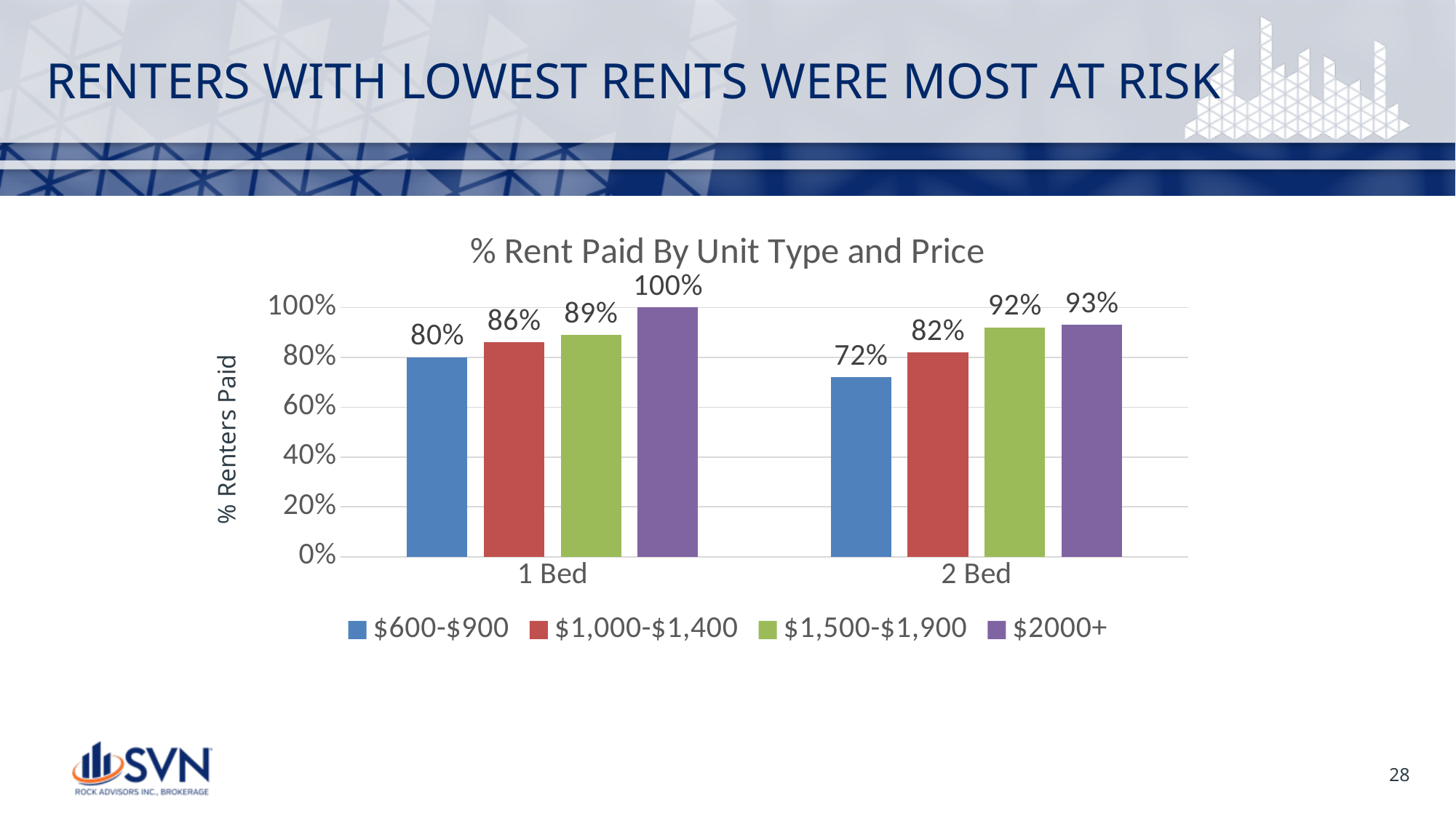
What is the value for $600-$900 in the 1 Bed category? 80% What is the difference between the $2000+ value for 1 Bed and the $2000+ value for 2 Bed? 7% What is the difference between the $600-$900 value and the $1,500-$1,900 value in the 2 Bed category? 20% How many unit type categories are shown on the x axis? 2 How many series does the legend list? 4 What kind of chart is shown on the slide? Bar chart Which price range has the highest value in the 1 Bed category? $2000+ What is the title of the chart? % Rent Paid By Unit Type and Price What is the value for $1,000-$1,400 in the 2 Bed category? 82% Which is larger: the $1,500-$1,900 value for 1 Bed or the $1,500-$1,900 value for 2 Bed? 2 Bed Which price range has the lowest value in the 2 Bed category? $600-$900 What is the value for $2000+ in the 2 Bed category? 93%